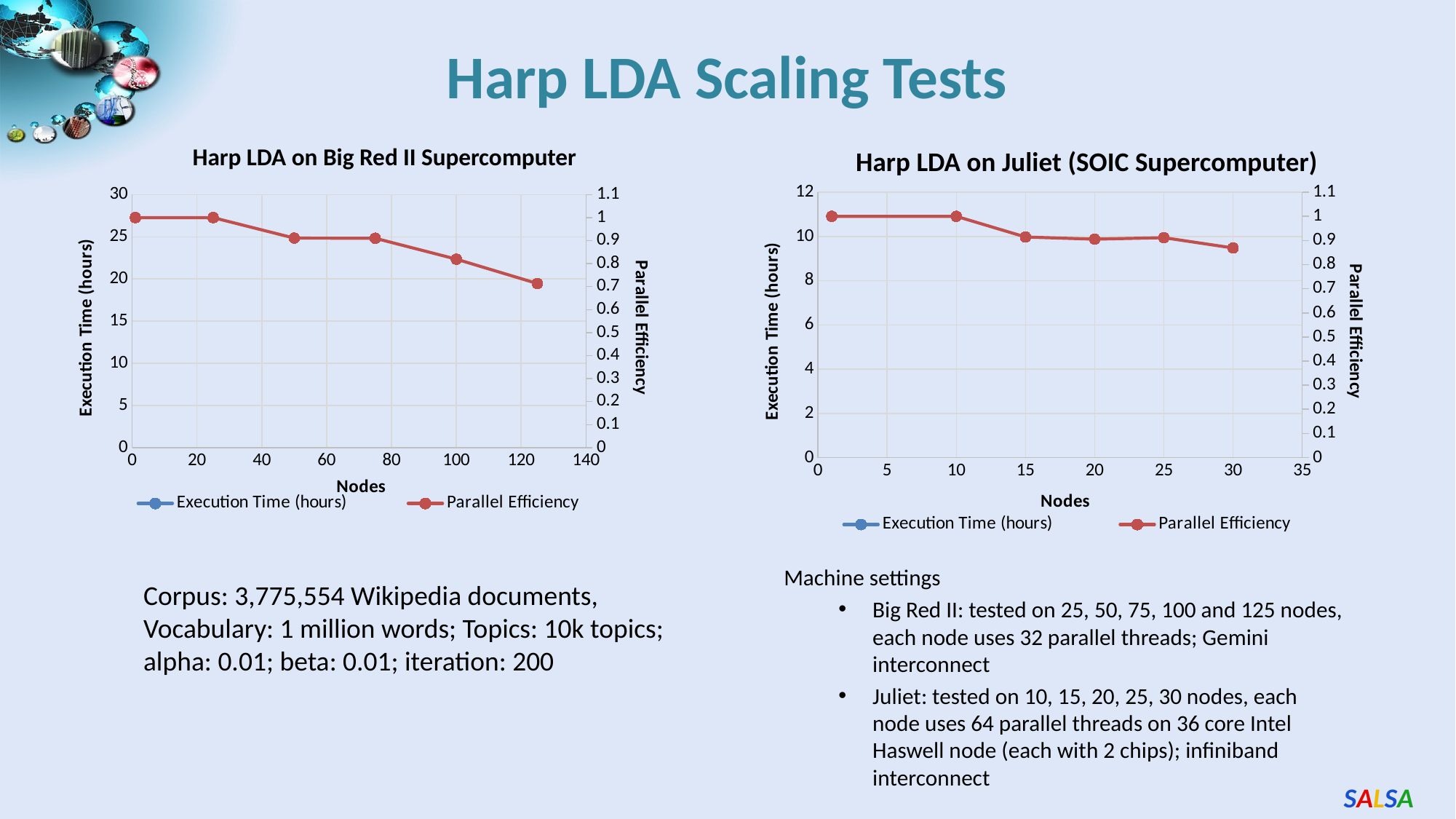
In "Harp LDA on Juliet (SOIC Supercomputer)", is the Parallel Efficiency at 15 nodes greater or less than 0.8? greater In "Harp LDA on Big Red II Supercomputer", does Parallel Efficiency rise or fall as the number of nodes increases? fall How many data points are plotted on the Parallel Efficiency line in "Harp LDA on Juliet (SOIC Supercomputer)"? 6 In "Harp LDA on Big Red II Supercomputer", is the Parallel Efficiency at 125 nodes greater or less than 0.8? less What is the title of the right-hand secondary y-axis in "Harp LDA on Big Red II Supercomputer"? Parallel Efficiency How many data points are plotted on the Parallel Efficiency line in "Harp LDA on Big Red II Supercomputer"? 6 In "Harp LDA on Big Red II Supercomputer", which is larger: the Parallel Efficiency at 25 nodes or at 125 nodes? 25 nodes How many series does the legend of "Harp LDA on Juliet (SOIC Supercomputer)" list? 2 In "Harp LDA on Big Red II Supercomputer", is the Parallel Efficiency at 25 nodes greater or less than 0.9? greater What is the x-axis title of "Harp LDA on Juliet (SOIC Supercomputer)"? Nodes What kind of chart is "Harp LDA on Big Red II Supercomputer"? line chart In "Harp LDA on Big Red II Supercomputer", at which number of nodes is Parallel Efficiency lowest? 125